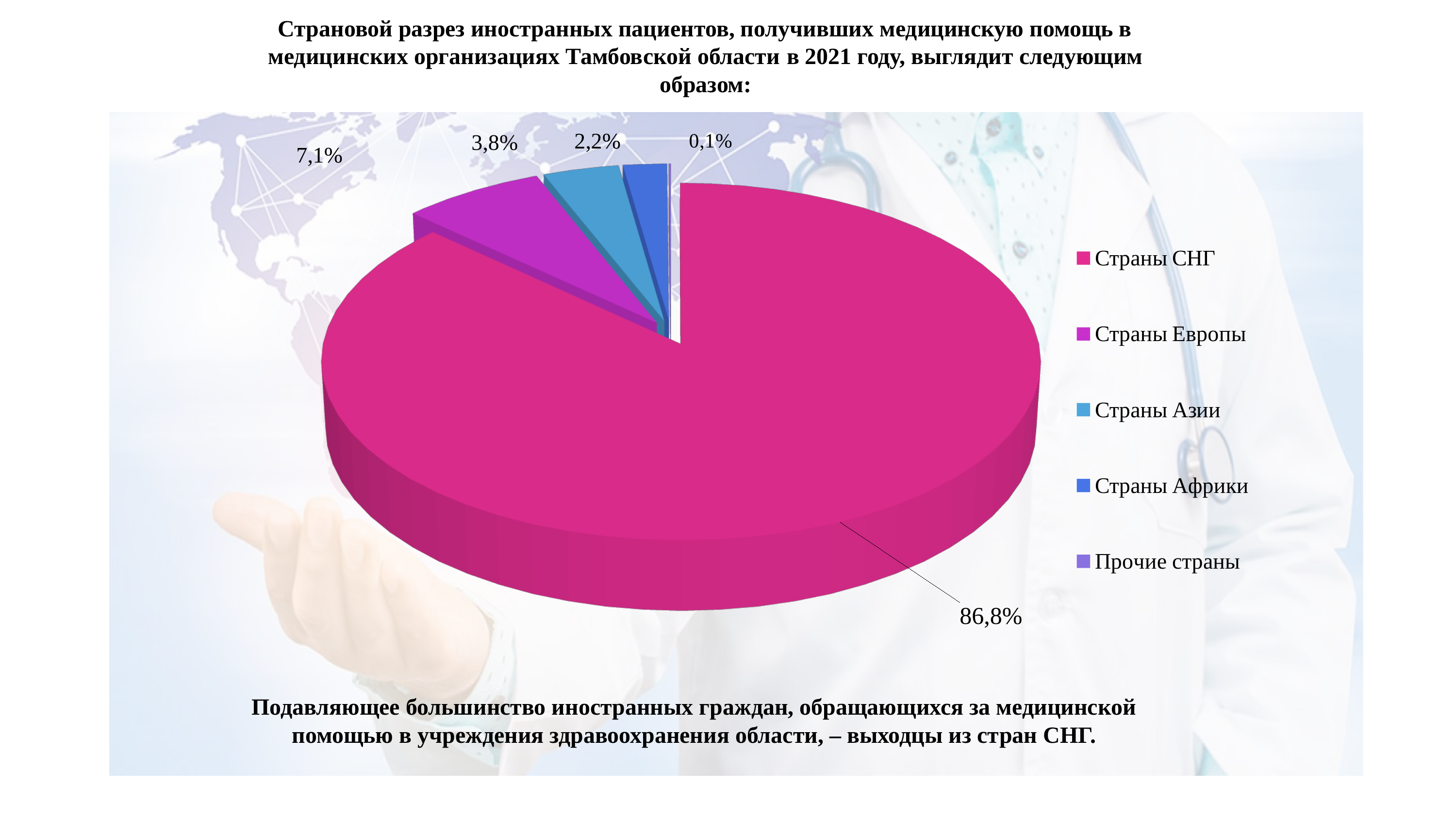
What colour is the slice for Страны СНГ? pink What is the value shown for Страны Европы? 7,1% Which category has the largest slice of the pie? Страны СНГ What share of the pie does Страны СНГ have? 86,8% Which is larger, the slice for Страны Европы or the slice for Страны Азии? Страны Европы What is the value shown for Страны Азии? 3,8% Which category has the smallest slice of the pie? Прочие страны What is the value shown for Страны Африки? 2,2% What is the value shown for Прочие страны? 0,1% What kind of chart is shown on the slide? pie chart How many categories does the legend list? 5 What is the difference in percentage points between Страны Европы and Страны Африки? 4,9